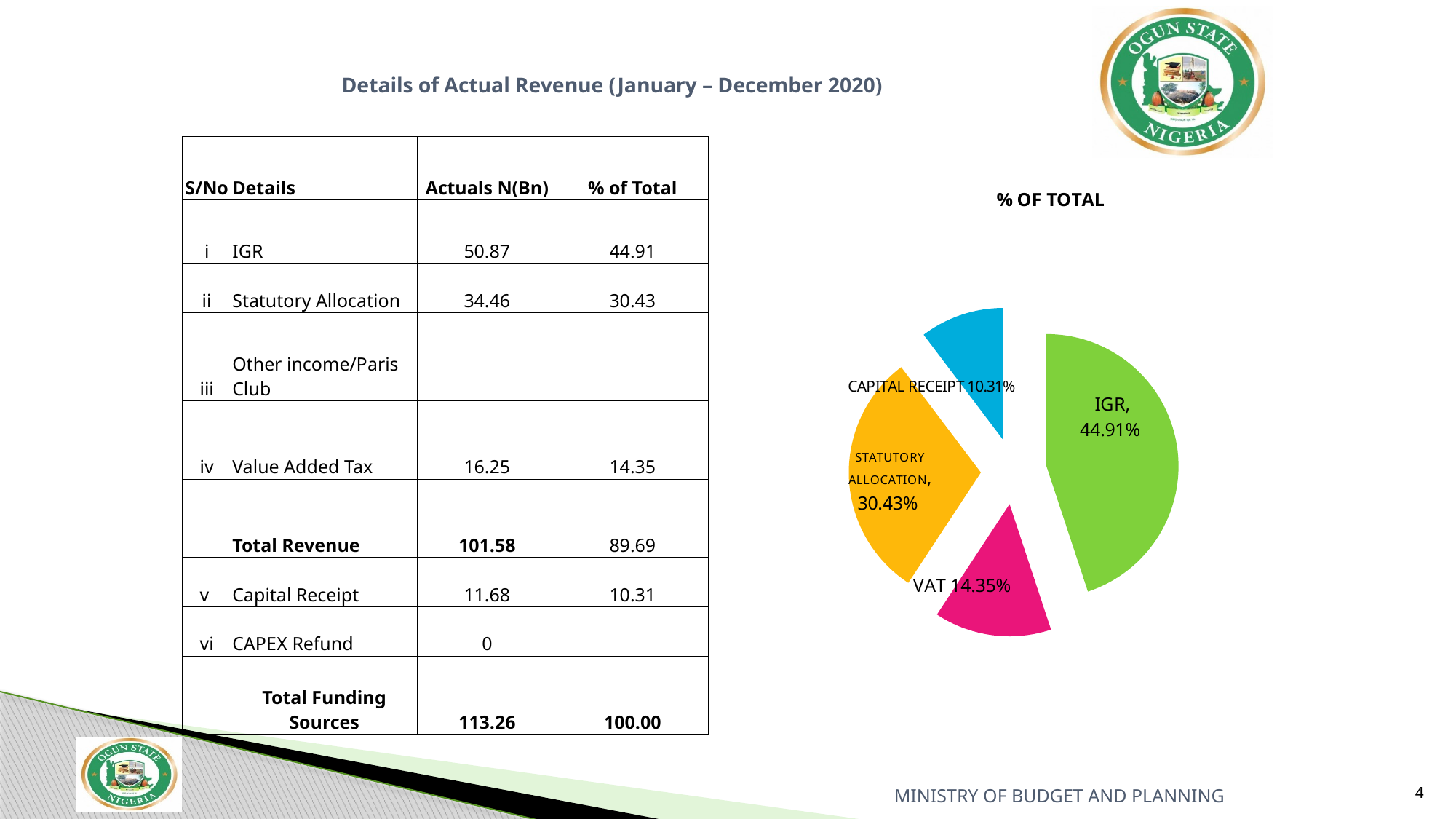
Which is larger, the VAT slice or the Capital Receipt slice? VAT What is the title of the chart? % OF TOTAL What share of the pie does Statutory Allocation represent? 30.43% What is the difference in percentage points between the IGR slice and the Statutory Allocation slice? 14.48 What share of the pie does Capital Receipt represent? 10.31% What share of the pie does IGR represent? 44.91% Which slice of the pie chart is the largest? IGR What share of the pie does VAT represent? 14.35% What colour is the IGR slice in the pie chart? green Which slice of the pie chart is the smallest? Capital Receipt How many slices does the pie chart have? 4 What type of chart is shown on the slide? pie chart